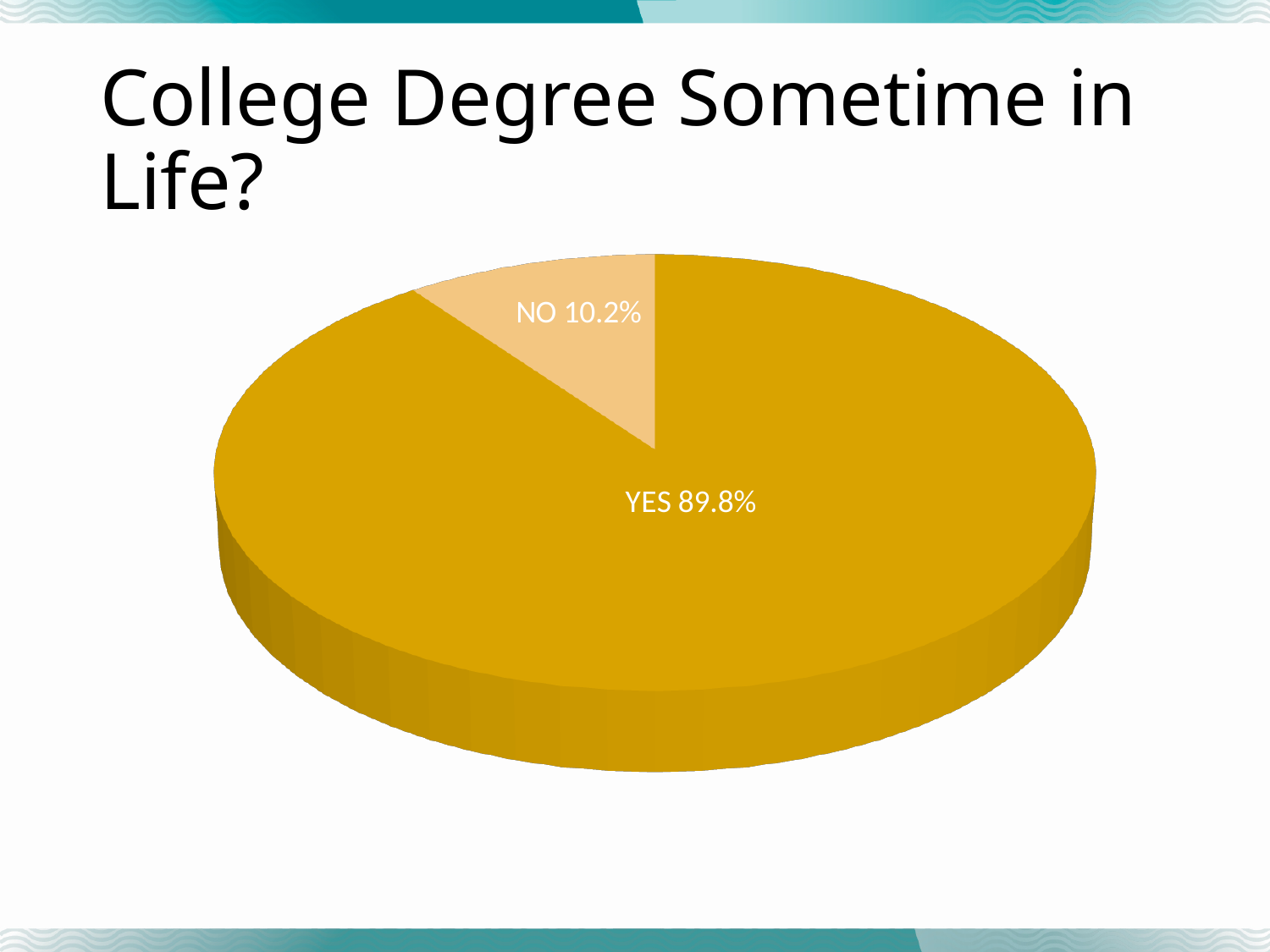
What is the difference in percentage points between the YES and NO slices? 79.6 Which slice is shown in the lighter colour? NO Which is larger, the YES slice or the NO slice? YES How many slices does the pie chart have? 2 What kind of chart is shown on the slide? pie chart Which slice is the largest? YES What is the title of the slide containing the pie chart? College Degree Sometime in Life? What percentage of respondents answered NO? 10.2% What share of the pie does the NO slice represent? 10.2% Which slice is the smallest? NO What percentage of respondents answered YES? 89.8%